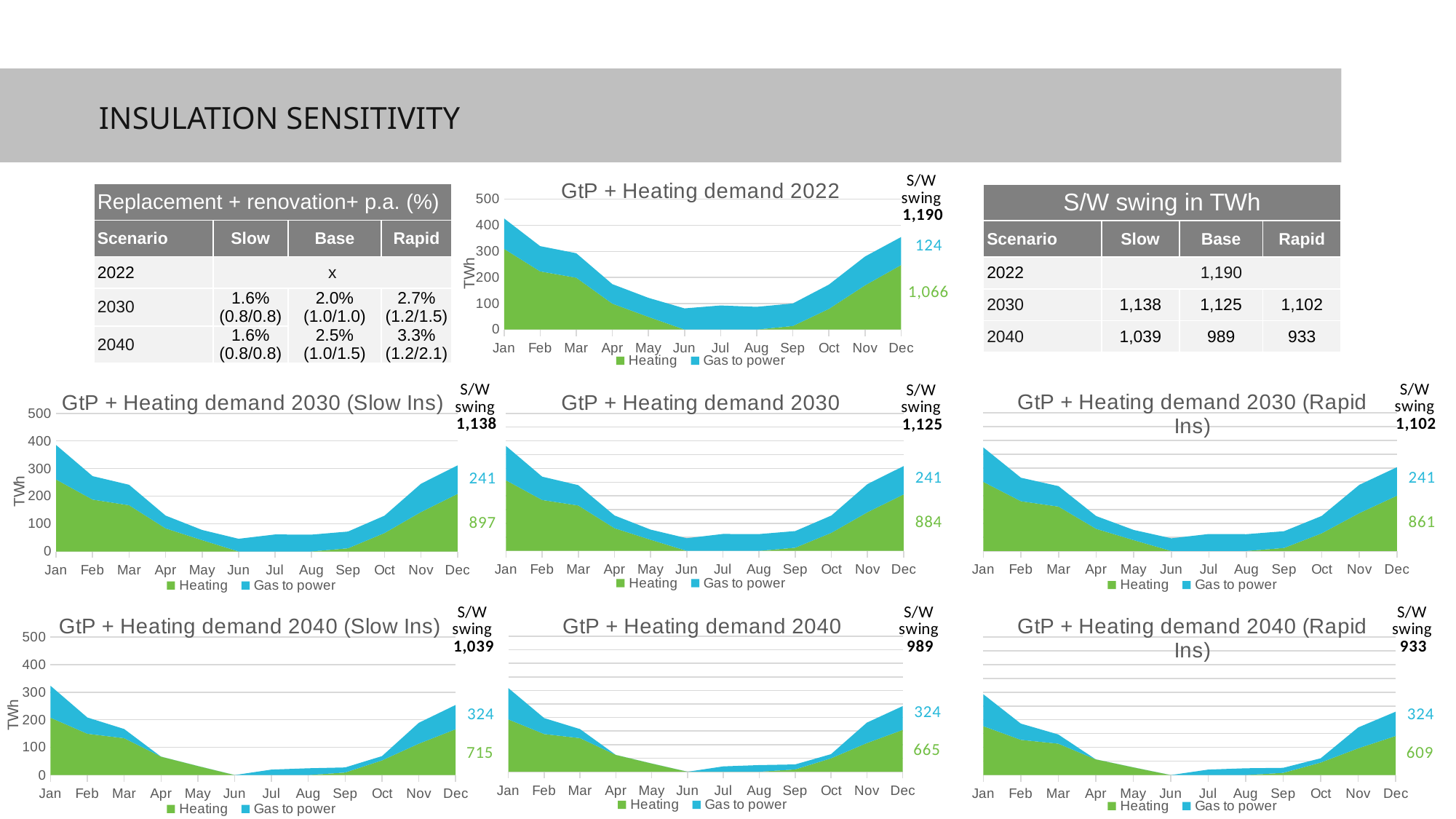
What S/W swing value is printed next to the "GtP + Heating demand 2040 (Rapid Ins)" chart? 933 How many months are shown on the x axis of the "GtP + Heating demand 2030 (Slow Ins)" chart? 12 In the "GtP + Heating demand 2030 (Slow Ins)" chart, do total values rise or fall from Jan to Jun? fall What kind of chart is "GtP + Heating demand 2022"? area chart In the "GtP + Heating demand 2030" chart, what colour represents the Heating series? green How many series does the legend of the "GtP + Heating demand 2022" chart list? 2 In the "GtP + Heating demand 2040 (Slow Ins)" chart, is the total demand in Jan greater or less than 200? greater In the "GtP + Heating demand 2040 (Rapid Ins)" chart, which month has the larger total demand, Jan or Jul? Jan What green (Heating) value is printed to the right of the "GtP + Heating demand 2030 (Rapid Ins)" chart? 861 What blue (Gas to power) value is printed to the right of the "GtP + Heating demand 2022" chart? 124 In the "GtP + Heating demand 2022" chart, is the total demand in Jun greater or less than 100? less What S/W swing value is printed next to the "GtP + Heating demand 2022" chart? 1,190